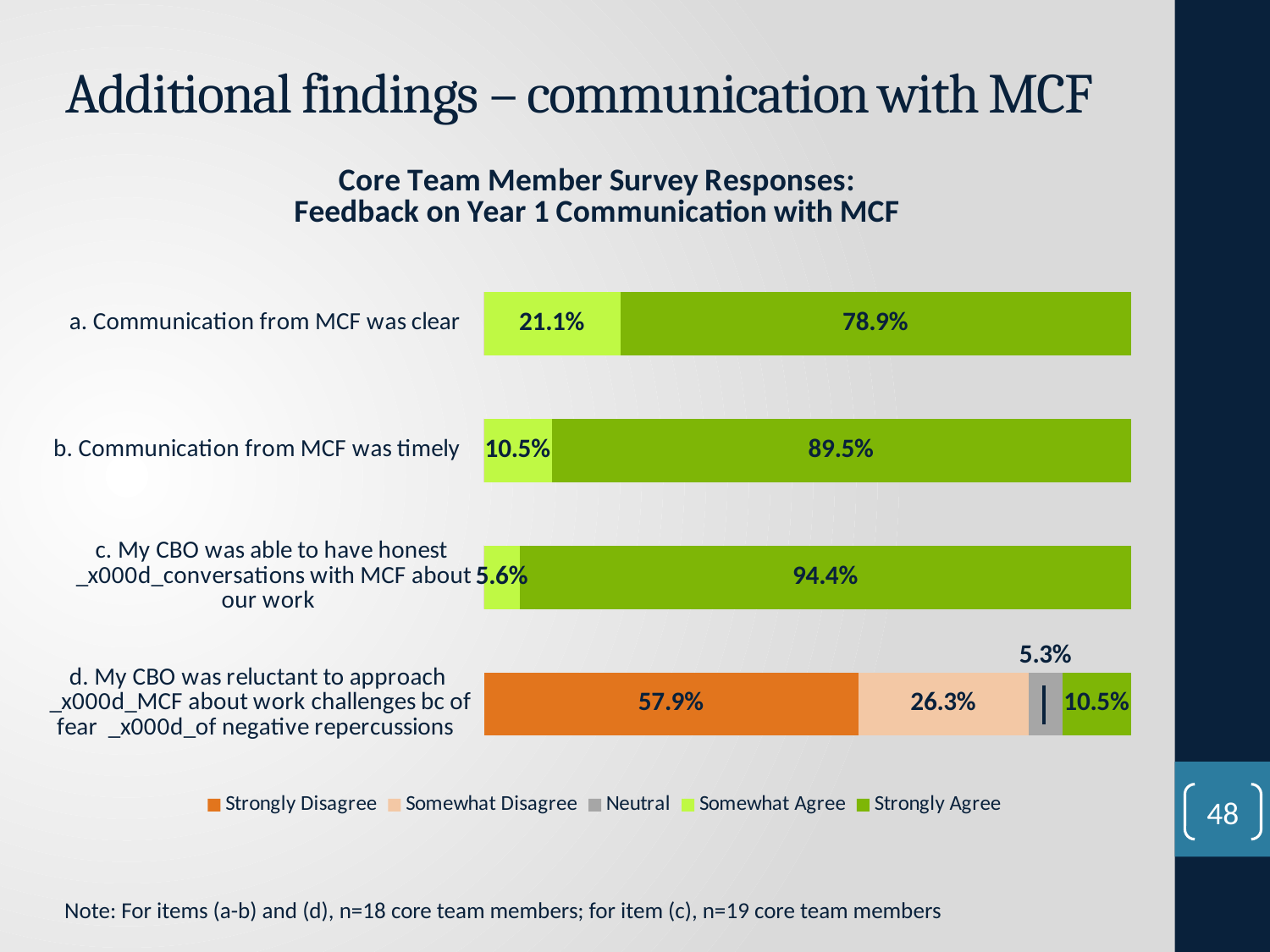
What is the difference between the Strongly Agree values for item b (timely) and item a (clear)? 10.6% Which is larger for item d: the Strongly Disagree value or the Somewhat Disagree value? Strongly Disagree What is the Strongly Disagree value for item d, 'My CBO was reluctant to approach MCF about work challenges bc of fear of negative repercussions'? 57.9% How many series does the legend list? 5 What kind of chart is shown on the slide? Stacked bar chart What is the title of the chart? Core Team Member Survey Responses: Feedback on Year 1 Communication with MCF Which item has the highest Strongly Agree value? c. My CBO was able to have honest conversations with MCF about our work What is the Strongly Agree value for 'a. Communication from MCF was clear'? 78.9% Which item has the lowest Strongly Agree value? d. My CBO was reluctant to approach MCF about work challenges bc of fear of negative repercussions How many survey items (categories) are shown in the chart? 4 What is the Neutral value for item d, 'My CBO was reluctant to approach MCF about work challenges'? 5.3% What is the Somewhat Agree value for 'b. Communication from MCF was timely'? 10.5%